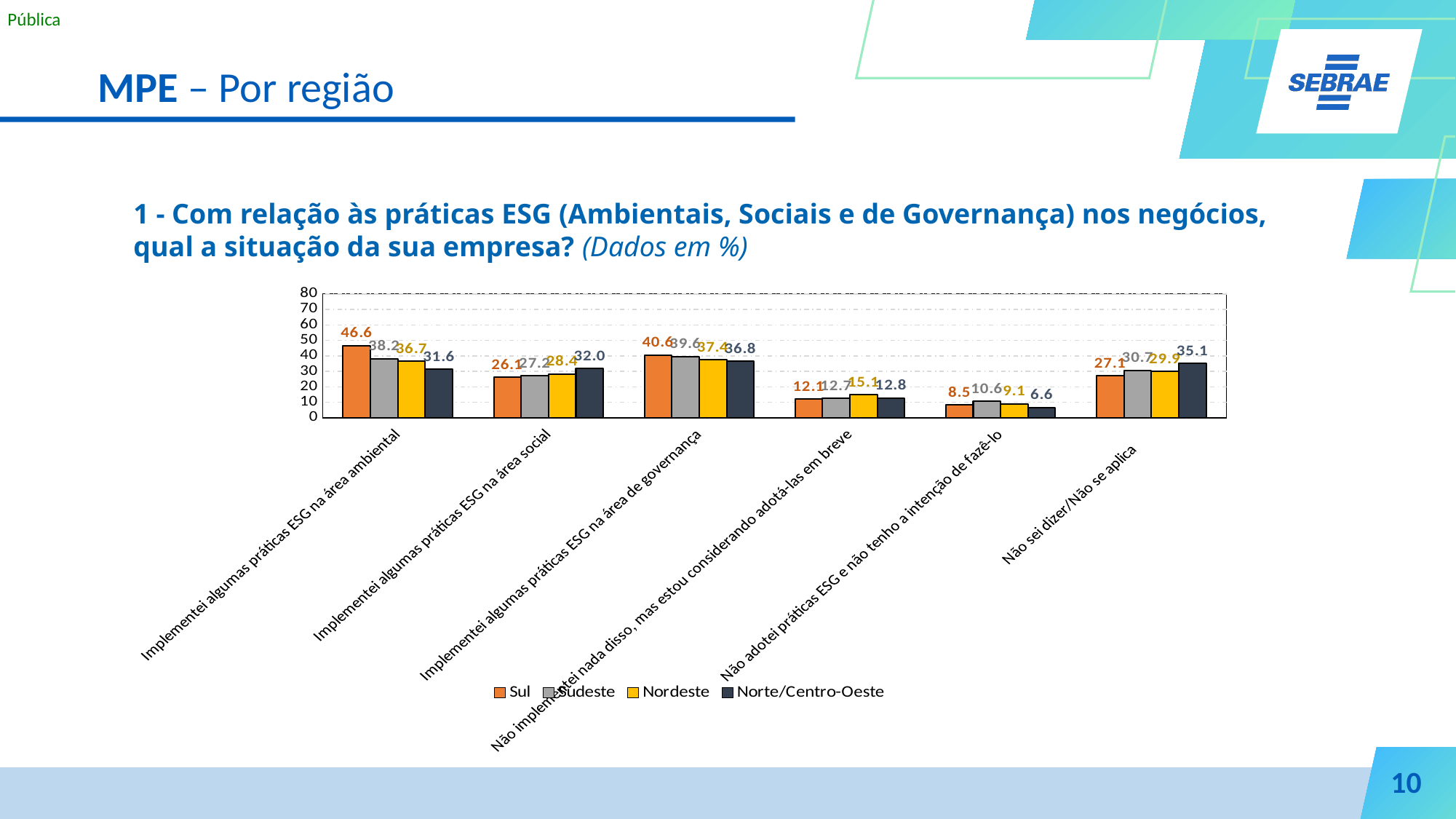
How many categories are shown on the x axis of the chart? 6 Which region has the highest value in the category 'Implementei algumas práticas ESG na área ambiental'? Sul What is the value for Norte/Centro-Oeste in the category 'Não sei dizer/Não se aplica'? 35.1 What is the value for Sul in the category 'Implementei algumas práticas ESG na área ambiental'? 46.6 Which region has the lowest value in the category 'Não adotei práticas ESG e não tenho a intenção de fazê-lo'? Norte/Centro-Oeste How many series does the legend list? 4 What is the difference between the Sul and Norte/Centro-Oeste values in the category 'Implementei algumas práticas ESG na área ambiental'? 15.0 What kind of chart is shown on the slide? bar chart Is the value for Sudeste in the category 'Não sei dizer/Não se aplica' greater or less than 40? less What is the value for Nordeste in the category 'Não implementei nada disso, mas estou considerando adotá-las em breve'? 15.1 In the category 'Implementei algumas práticas ESG na área social', which is larger: the value for Sul or for Norte/Centro-Oeste? Norte/Centro-Oeste Which colour represents the Nordeste series in the chart? yellow